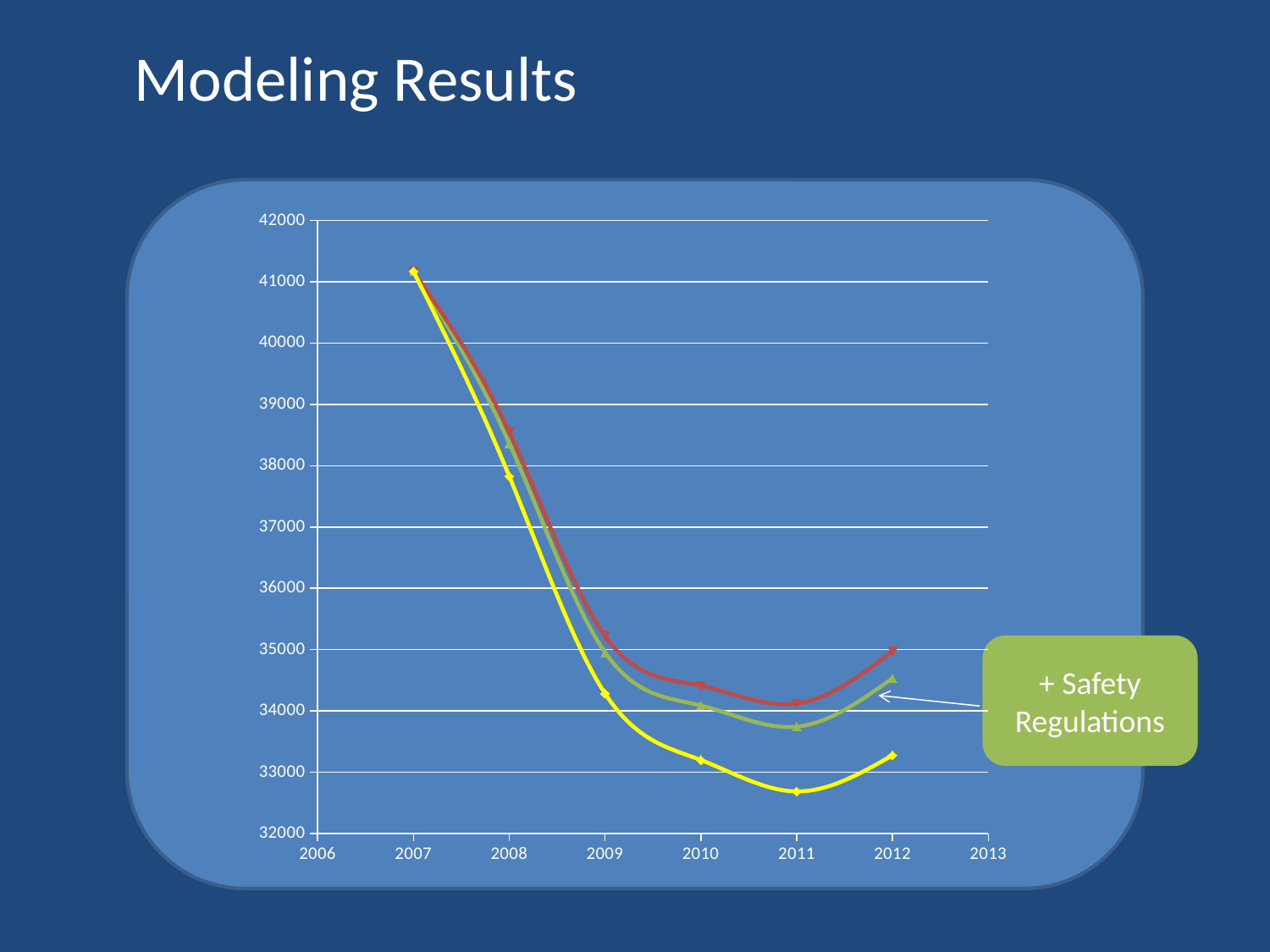
Is the value of the yellow line in 2011 greater or less than 33000? less Is the value of the red line in 2010 greater or less than 34000? greater Is the value of the green line in 2011 greater or less than 34000? less What does the green callout box next to the chart say? + Safety Regulations Do the values fall or rise from 2007 to 2011? fall In 2011, which line has the higher value, the red line or the yellow line? red line How many data points does each line have? 6 What kind of chart is shown on the slide? line chart How many lines are plotted on the chart? 3 In which year does the yellow line reach its lowest value? 2011 In which year do the lines reach their highest value? 2007 What is the title of the slide containing the chart? Modeling Results